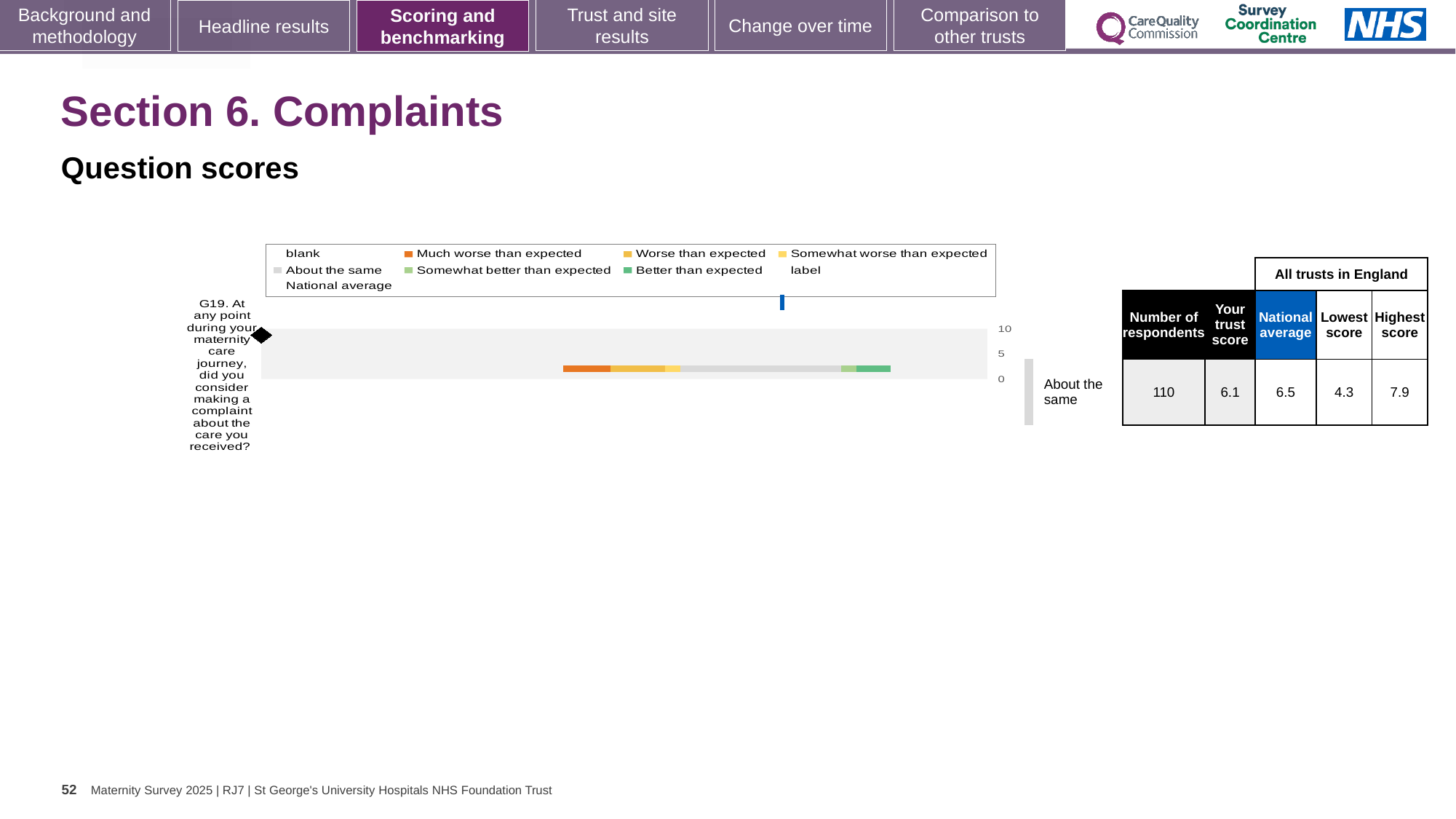
By how much does the national average exceed the trust score for question G19? 0.4 Which is larger for question G19, the trust score or the national average? National average What is the number of respondents for question G19? 110 What is the lowest score among all trusts in England for question G19? 4.3 What is the trust score for question G19? 6.1 What is the difference between the highest and lowest trust scores for question G19? 3.6 What kind of chart is used to show the question score for G19? Bar chart What is the question label shown on the chart's category axis? G19. At any point during your maternity care journey, did you consider making a complaint about the care you received? How many survey questions are plotted on the chart? 1 Which benchmark category is question G19 placed in? About the same What is the national average score for question G19? 6.5 What is the highest score among all trusts in England for question G19? 7.9